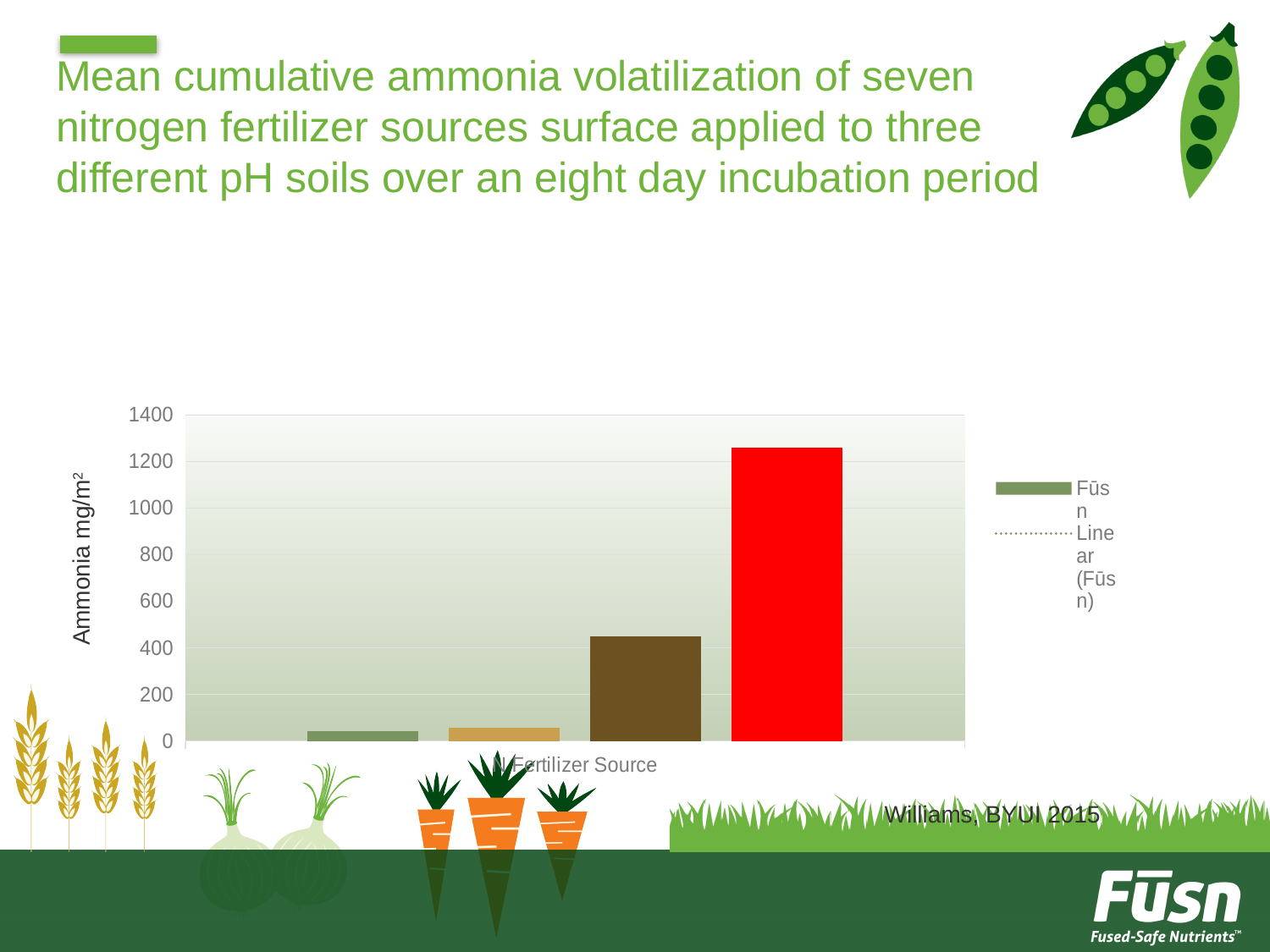
Is the value of the brown bar greater or less than 600? less What kind of chart is shown on the slide? bar chart Which is larger, the brown bar or the tan bar? the brown bar How many entries does the chart legend list? 2 Which bar is the shortest in the chart? the green bar (first from the left) Is the value of the brown bar greater or less than 400? greater How many bars are plotted in the chart? 4 Is the value of the tan (second) bar greater or less than 200? less What is the label on the vertical axis of the chart? Ammonia mg/m² Do the bar values rise or fall from left to right along the x axis? rise Which bar is the tallest in the chart? the red bar (fourth from the left)